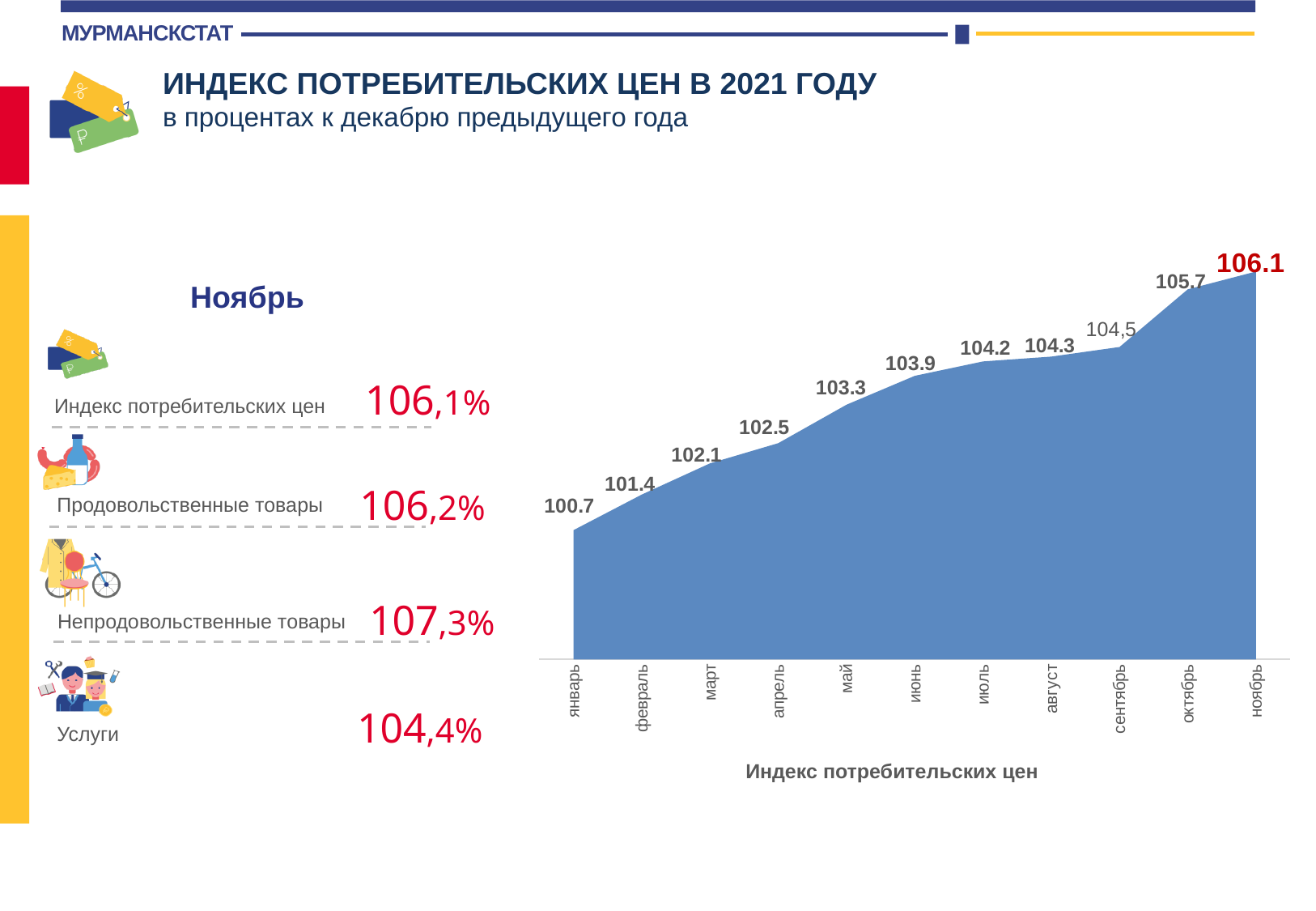
What is the difference between the values for ноябрь and январь on the chart? 5.4 What is the value of the consumer price index for январь on the chart? 100.7 What is the value shown for май on the chart? 103.3 What is the value shown for ноябрь on the chart? 106.1 Which month has the highest value on the chart? ноябрь What type of chart is shown on the slide? area chart Which month has the lowest value on the chart? январь What is the value shown for сентябрь on the chart? 104,5 Which is larger on the chart, the value for июль or the value for апрель? июль Do the values on the chart rise or fall from январь to ноябрь? rise How many months are plotted on the chart? 11 What is the difference between the values for октябрь and сентябрь on the chart? 1.2